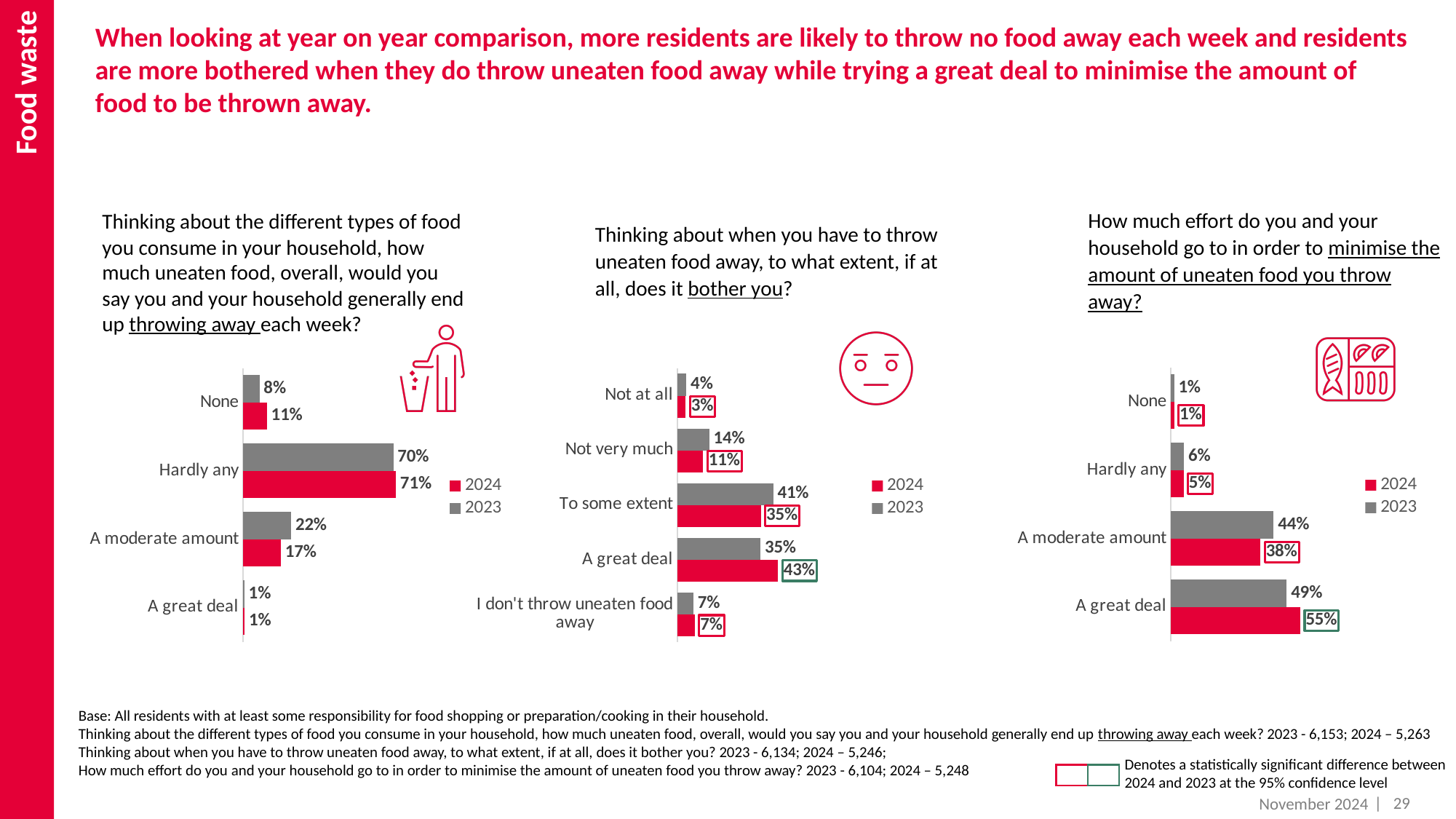
In the middle chart about how much it bothers residents to throw uneaten food away, which category has the lowest 2024 value? Not at all In the middle chart about how much it bothers residents to throw uneaten food away, what is the 2024 value for 'A great deal'? 43% In the middle chart about how much it bothers residents to throw uneaten food away, how many categories are shown? 5 In the left chart about how much uneaten food is thrown away each week, which category has the highest 2024 value? Hardly any In the middle chart about how much it bothers residents to throw uneaten food away, what is the 2023 value for 'To some extent'? 41% How many series does the legend of the right chart about effort to minimise uneaten food thrown away list? 2 In the left chart about how much uneaten food is thrown away each week, what is the 2024 value for 'Hardly any'? 71% In the right chart about effort to minimise uneaten food thrown away, is the 2023 value for 'A moderate amount' larger or smaller than the 2024 value? larger In the right chart about effort to minimise uneaten food thrown away, what is the 2024 value for 'A great deal'? 55% In the left chart about how much uneaten food is thrown away each week, what is the 2023 value for 'A moderate amount'? 22% In the left chart about how much uneaten food is thrown away each week, what is the difference between the 2024 and 2023 values for 'None'? 3 percentage points In the right chart about effort to minimise uneaten food thrown away, what is the difference between the 2024 and 2023 values for 'A great deal'? 6 percentage points